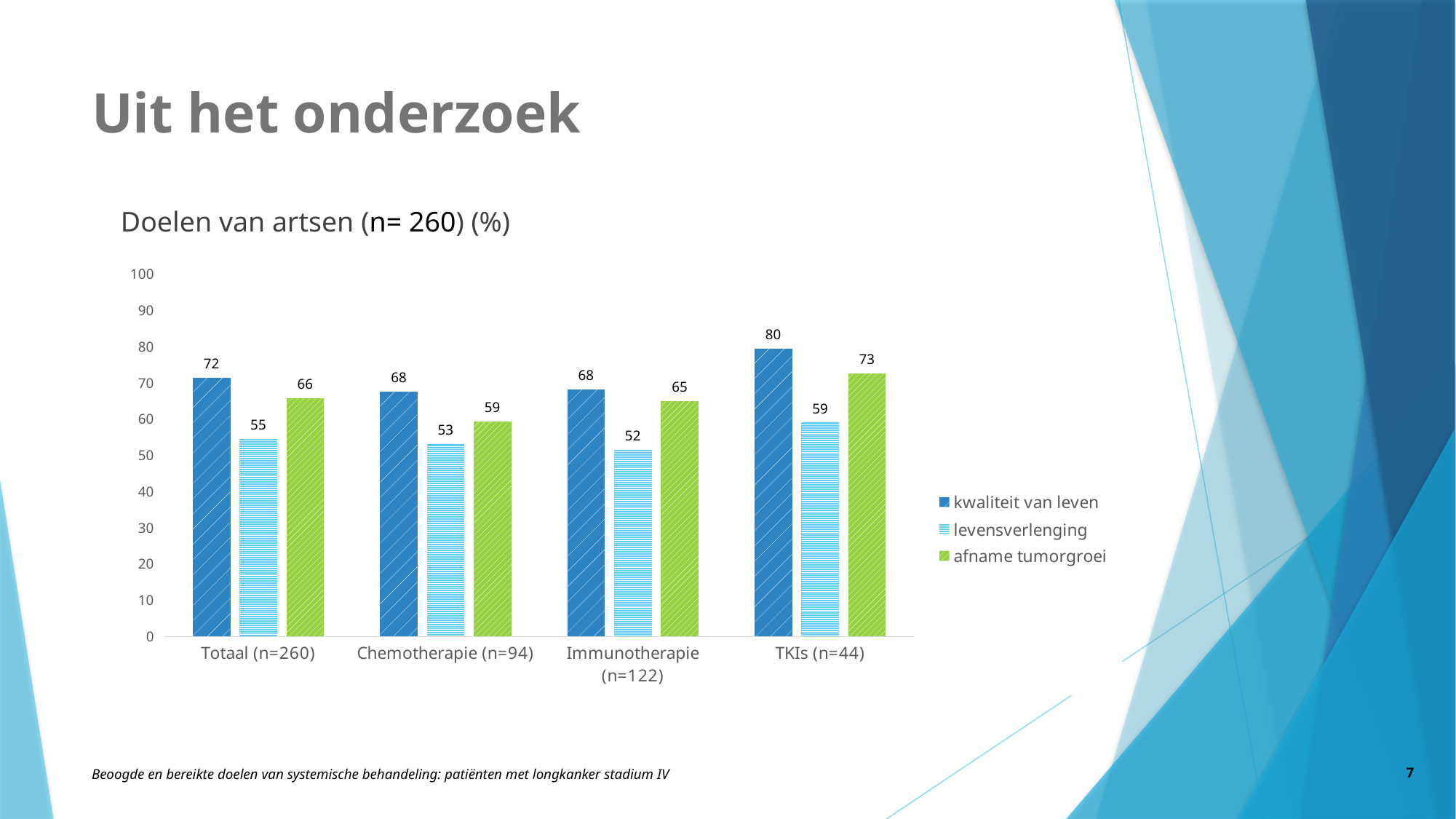
Is the value for 'kwaliteit van leven' in the Chemotherapie (n=94) category greater or less than 60? greater What is the value for 'levensverlenging' in the Immunotherapie (n=122) category? 52 What is the difference between 'kwaliteit van leven' and 'levensverlenging' in the Totaal (n=260) category? 17 What is the value for 'kwaliteit van leven' in the TKIs (n=44) category? 80 What kind of chart is shown on the slide? bar chart How many categories are shown on the x axis? 4 Which category has the lowest value for 'levensverlenging'? Immunotherapie (n=122) Which category has the highest value for 'kwaliteit van leven'? TKIs (n=44) What is the title of the chart? Doelen van artsen (n= 260) (%) How many series does the legend list? 3 Which is larger in the TKIs (n=44) category: 'afname tumorgroei' or 'levensverlenging'? afname tumorgroei What is the value for 'afname tumorgroei' in the Chemotherapie (n=94) category? 59